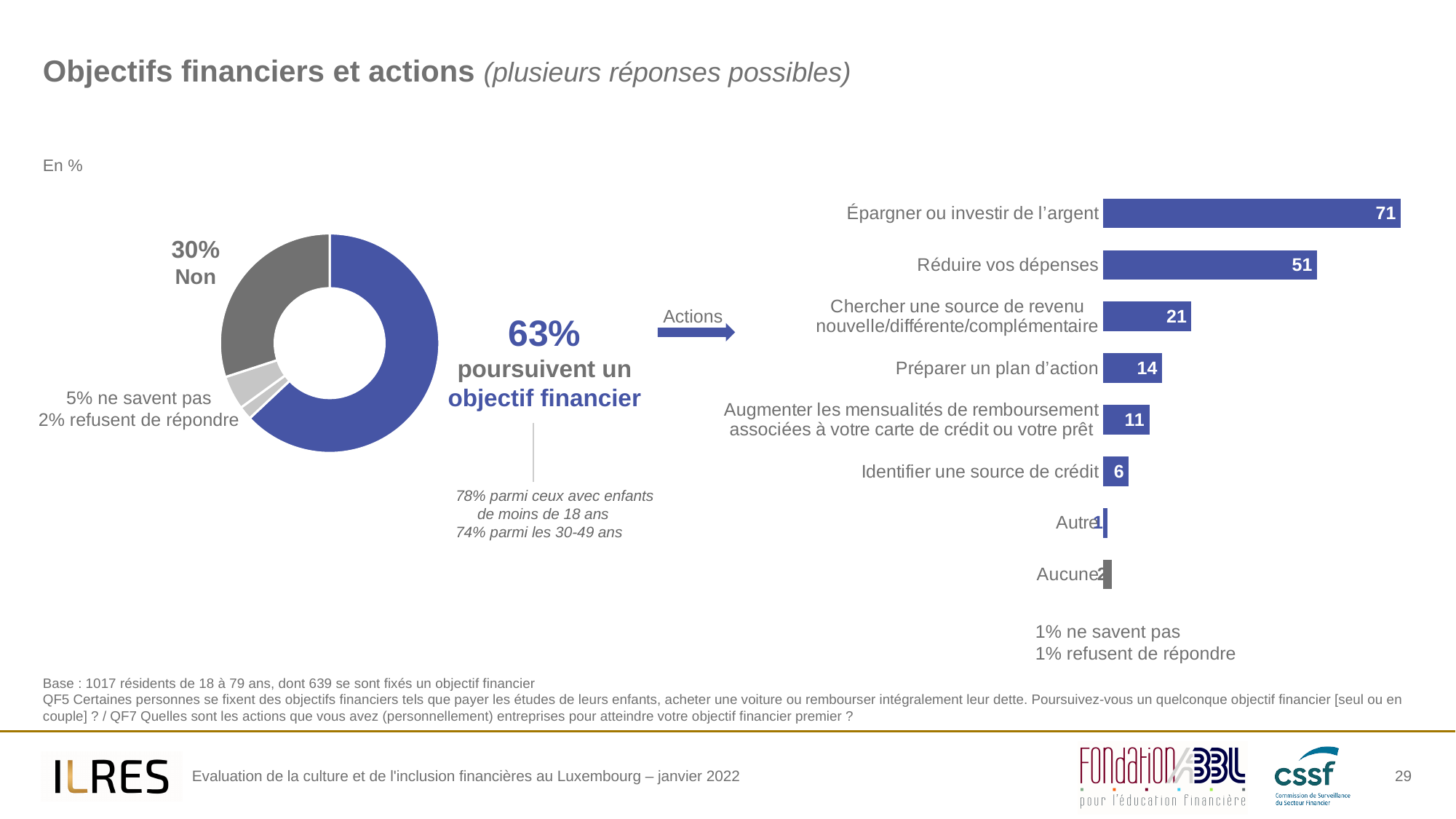
In the donut chart on the left, what share of respondents pursue a financial objective? 63% In the bar chart on the right, what is the value for "Préparer un plan d'action"? 14 In the bar chart on the right, which is larger: "Chercher une source de revenu nouvelle/différente/complémentaire" or "Augmenter les mensualités de remboursement associées à votre carte de crédit ou votre prêt"? Chercher une source de revenu nouvelle/différente/complémentaire How many categories are shown in the bar chart on the right? 8 In the bar chart on the right, what is the value for "Épargner ou investir de l'argent"? 71 In the donut chart on the left, what share answered "Non"? 30% What kind of chart is on the right side of the slide? Bar chart In the bar chart on the right, what is the value for "Réduire vos dépenses"? 51 In the bar chart on the right, which action has the highest value? Épargner ou investir de l'argent In the bar chart on the right, what is the difference between "Épargner ou investir de l'argent" and "Réduire vos dépenses"? 20 In the bar chart on the right, which category has the lowest value? Autre In the bar chart on the right, what is the value for "Identifier une source de crédit"? 6